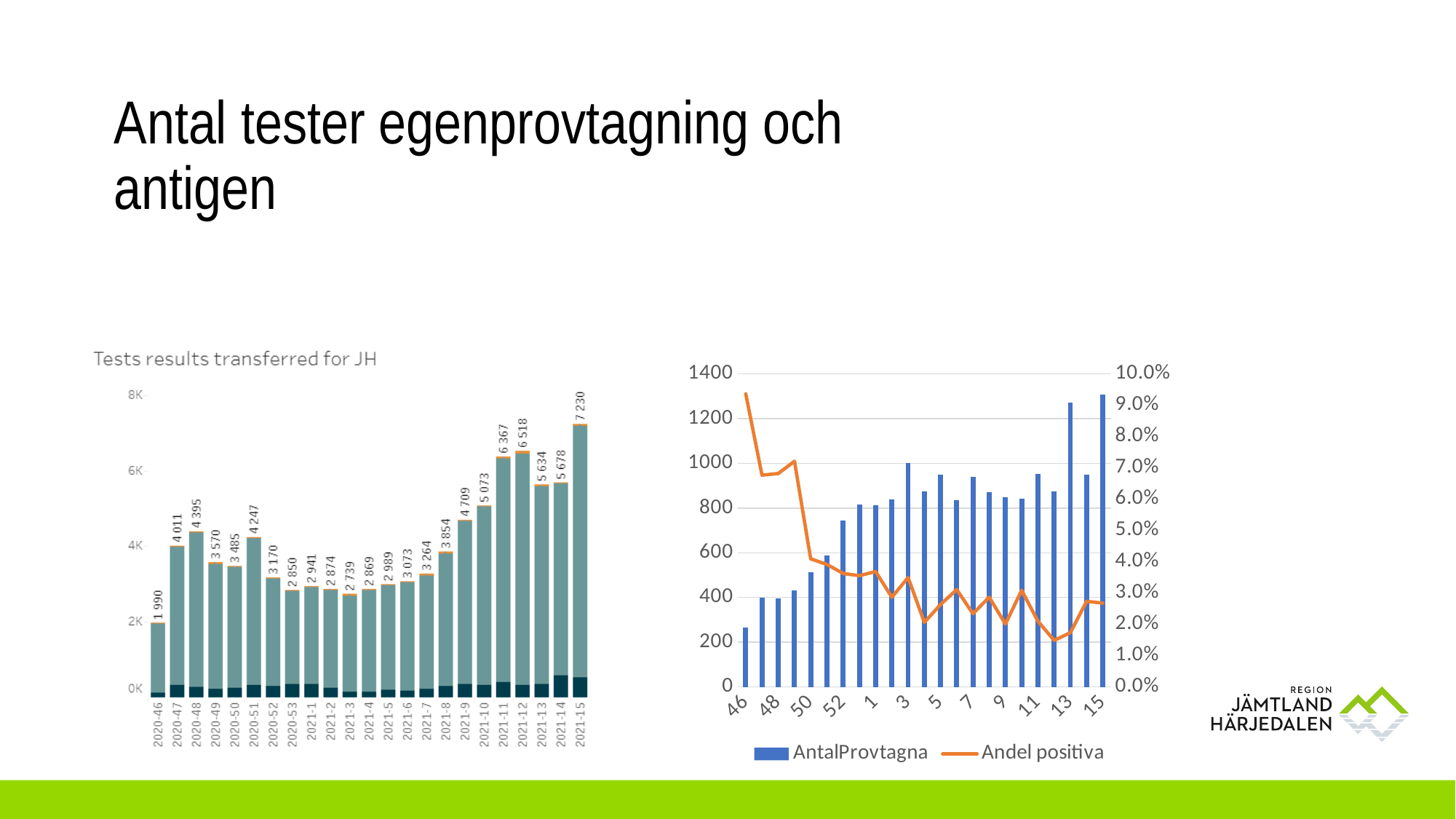
In the right chart, is the Andel positiva value for week 46 greater or less than 8.0%? greater In the right chart, how many series does the legend list? 2 What type of chart is the left chart 'Tests results transferred for JH'? Bar chart In the left chart 'Tests results transferred for JH', which period has the highest value? 2021-15 In the left chart 'Tests results transferred for JH', which is larger, the value for 2021-11 or 2021-12? 2021-12 In the left chart 'Tests results transferred for JH', what is the value for 2020-46? 1 990 In the right chart, is the AntalProvtagna value for week 46 greater or less than 400? less In the left chart 'Tests results transferred for JH', what is the difference between the values for 2021-15 and 2020-46? 5 240 In the right chart, is the AntalProvtagna value for week 13 greater or less than 1200? greater In the left chart 'Tests results transferred for JH', which period has the lowest value? 2020-46 In the left chart 'Tests results transferred for JH', how many periods are shown on the x axis? 23 In the left chart 'Tests results transferred for JH', what is the value for 2021-15? 7 230